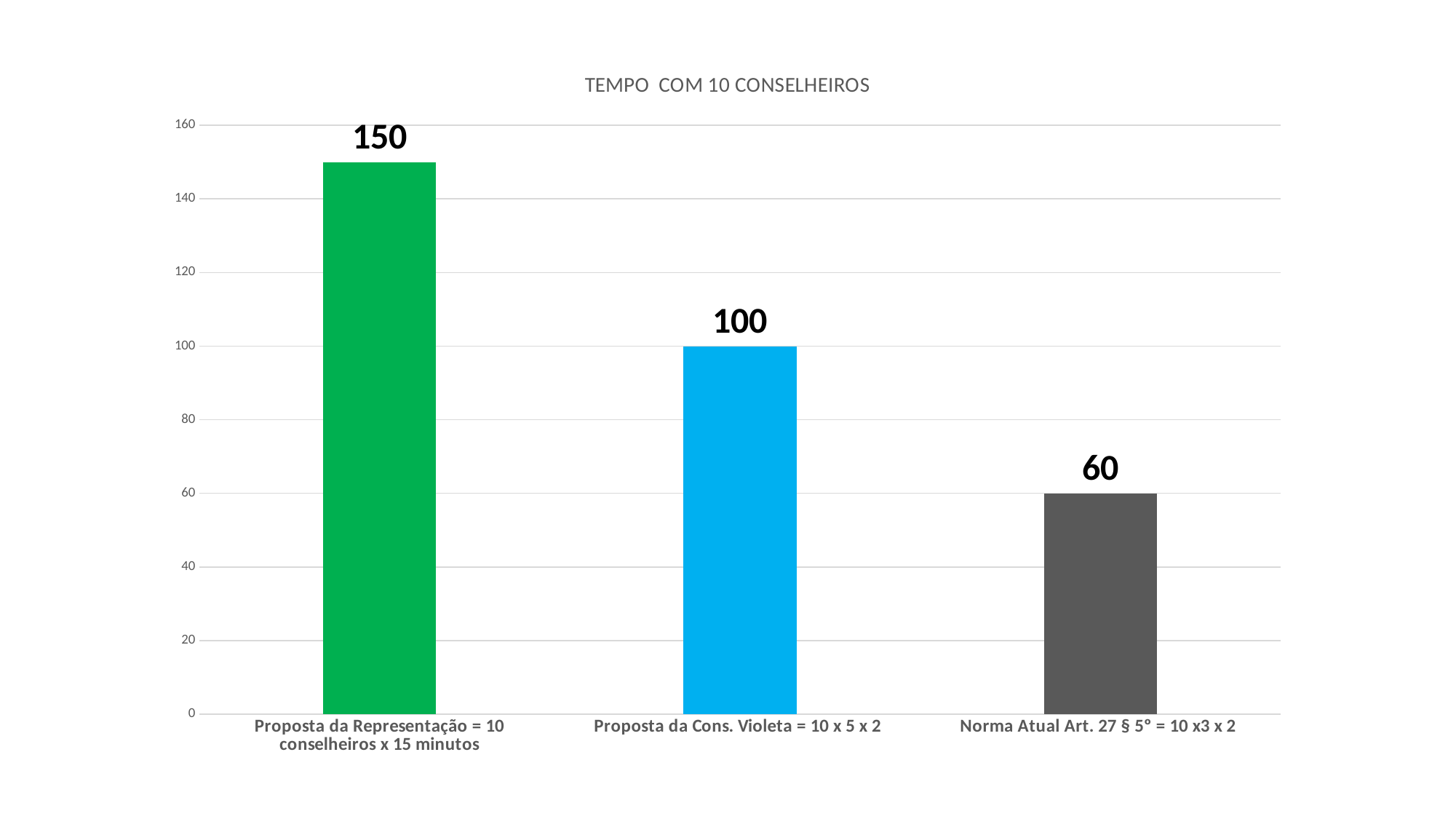
What is the value for "Proposta da Representação = 10 conselheiros x 15 minutos"? 150 What is the title of the chart? TEMPO COM 10 CONSELHEIROS How many categories are shown in the chart? 3 Which category has the highest value? Proposta da Representação = 10 conselheiros x 15 minutos Which category has the lowest value? Norma Atual Art. 27 § 5° = 10 x3 x 2 What is the difference between the values for "Proposta da Cons. Violeta" and "Norma Atual Art. 27 § 5°"? 40 What is the value for "Norma Atual Art. 27 § 5° = 10 x3 x 2"? 60 What is the value for "Proposta da Cons. Violeta = 10 x 5 x 2"? 100 What is the difference between the values for "Proposta da Representação" and "Norma Atual Art. 27 § 5°"? 90 Which is larger, the value for "Proposta da Cons. Violeta" or the value for "Norma Atual Art. 27 § 5°"? Proposta da Cons. Violeta What kind of chart is shown on the slide? bar chart Is the value for "Proposta da Representação" greater or less than 140? greater